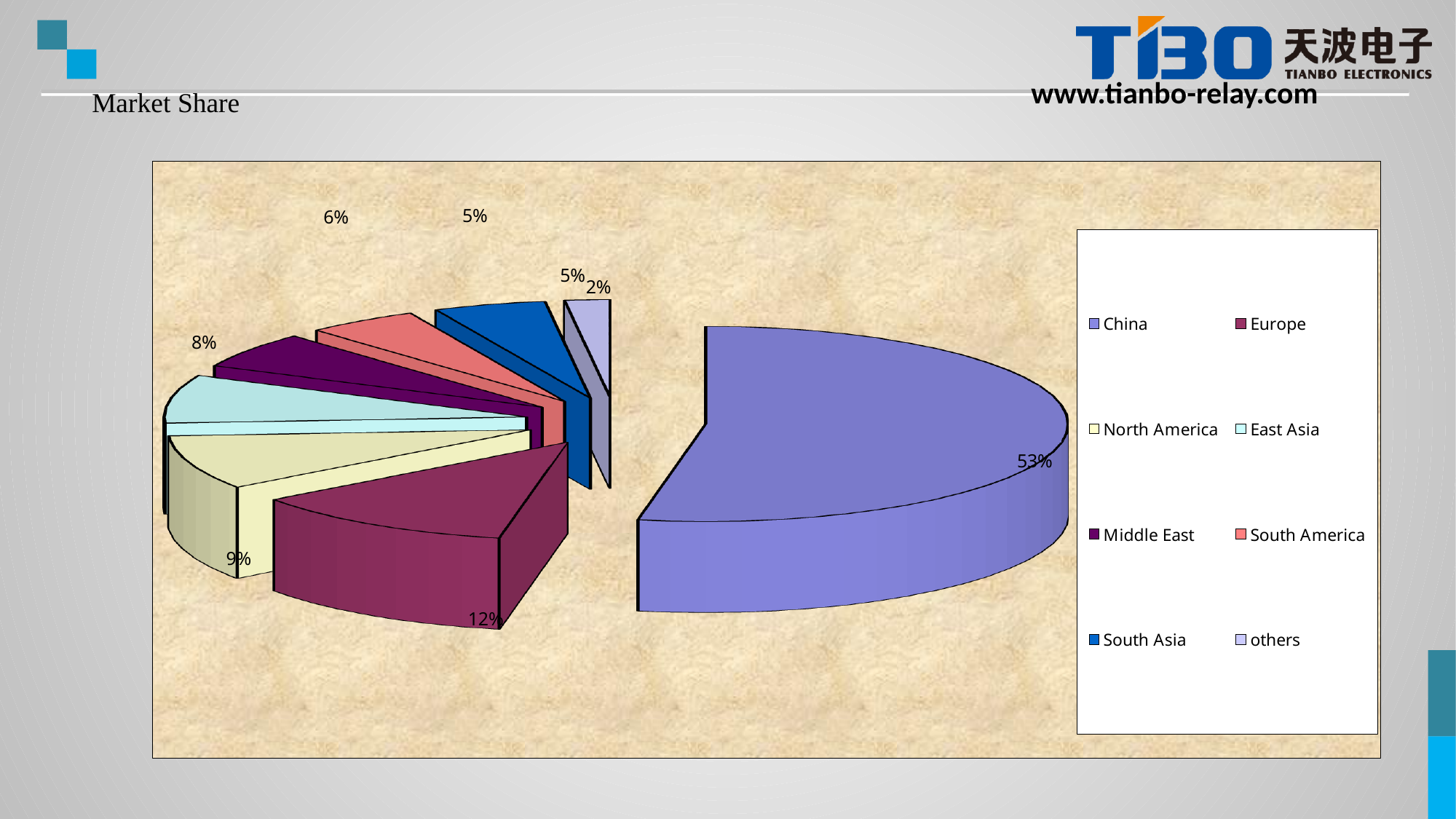
What percentage is shown for the 'others' slice? 2% What percentage is shown for East Asia? 8% How many slices does the pie chart have? 8 Which region has the largest share of the pie? China Which slice has the smallest share of the pie? others What share of the pie does China hold? 53% Which has the larger share, Europe or North America? Europe How many percentage points larger is China's share than Europe's? 41 percentage points What type of chart is shown on the slide? Pie chart What percentage is shown for North America? 9% What percentage is shown for Middle East? 6% What percentage is shown for Europe? 12%